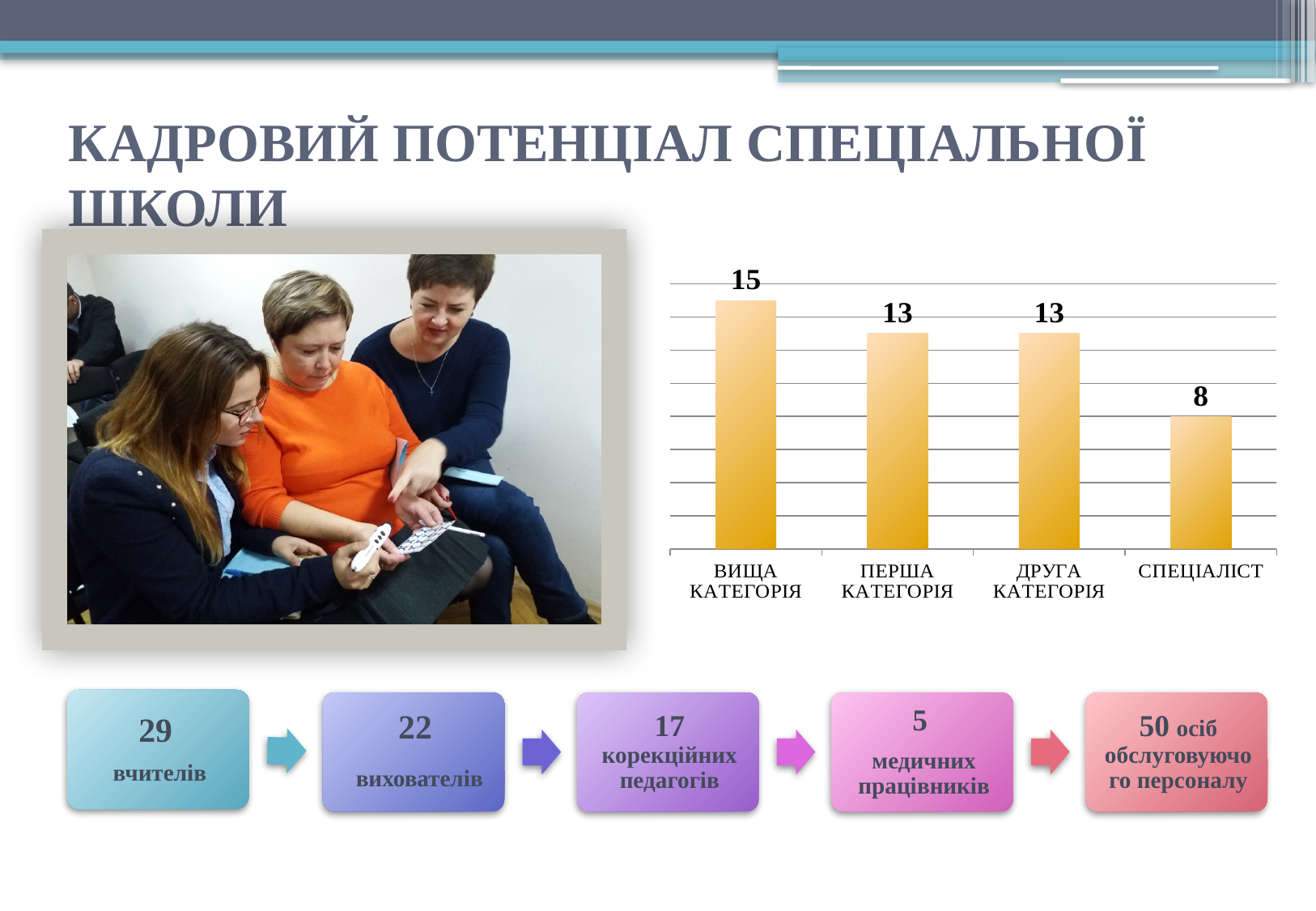
What kind of chart is shown on the slide? bar chart What is the value for ДРУГА КАТЕГОРІЯ? 13 How many categories are shown in the chart? 4 What is the value for ПЕРША КАТЕГОРІЯ? 13 What is the value for СПЕЦІАЛІСТ? 8 Which category has the highest value? ВИЩА КАТЕГОРІЯ What is the value for ВИЩА КАТЕГОРІЯ? 15 Do the values rise or fall from ВИЩА КАТЕГОРІЯ to СПЕЦІАЛІСТ along the x axis? fall Which category has the lowest value? СПЕЦІАЛІСТ What is the difference between the values for ВИЩА КАТЕГОРІЯ and ПЕРША КАТЕГОРІЯ? 2 What is the difference between the values for ВИЩА КАТЕГОРІЯ and СПЕЦІАЛІСТ? 7 Which is larger, the value for ДРУГА КАТЕГОРІЯ or the value for СПЕЦІАЛІСТ? ДРУГА КАТЕГОРІЯ